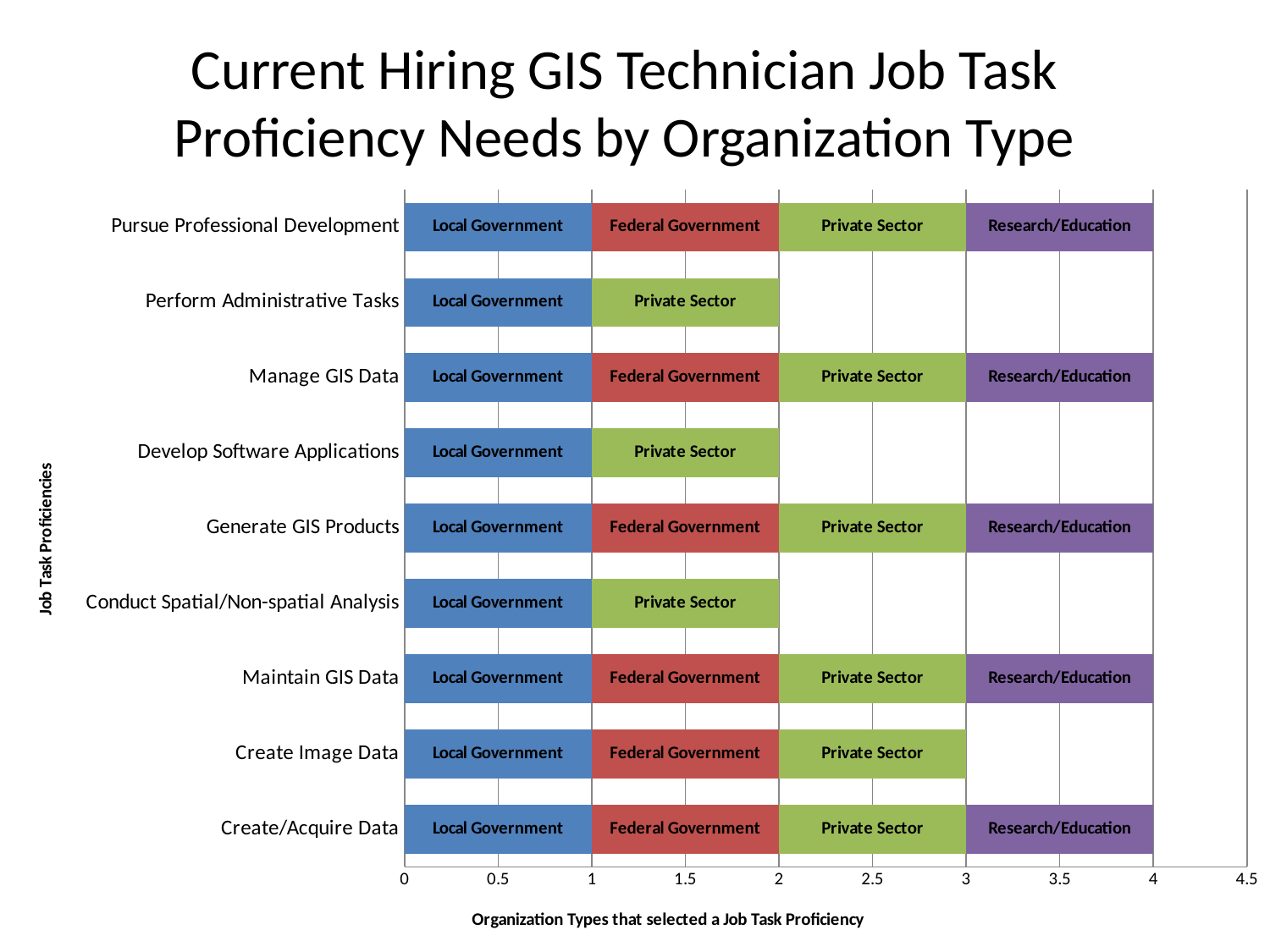
What is the title of the x axis? Organization Types that selected a Job Task Proficiency Which organization types selected Develop Software Applications? Local Government, Private Sector Which organization type is missing from the Create Image Data bar? Research/Education How many organization types selected Create Image Data in total? 3 Is the total for Create Image Data greater or less than 2? greater How many organization types selected Pursue Professional Development in total? 4 Which has more organization types selecting it: Create Image Data or Maintain GIS Data? Maintain GIS Data What kind of chart is shown on the slide? Bar chart How many job task proficiencies are listed on the y axis? 9 How many organization types selected Perform Administrative Tasks in total? 2 How many job task proficiencies have a total of 4 organization types? 5 What is the difference between the total for Create/Acquire Data and the total for Create Image Data? 1